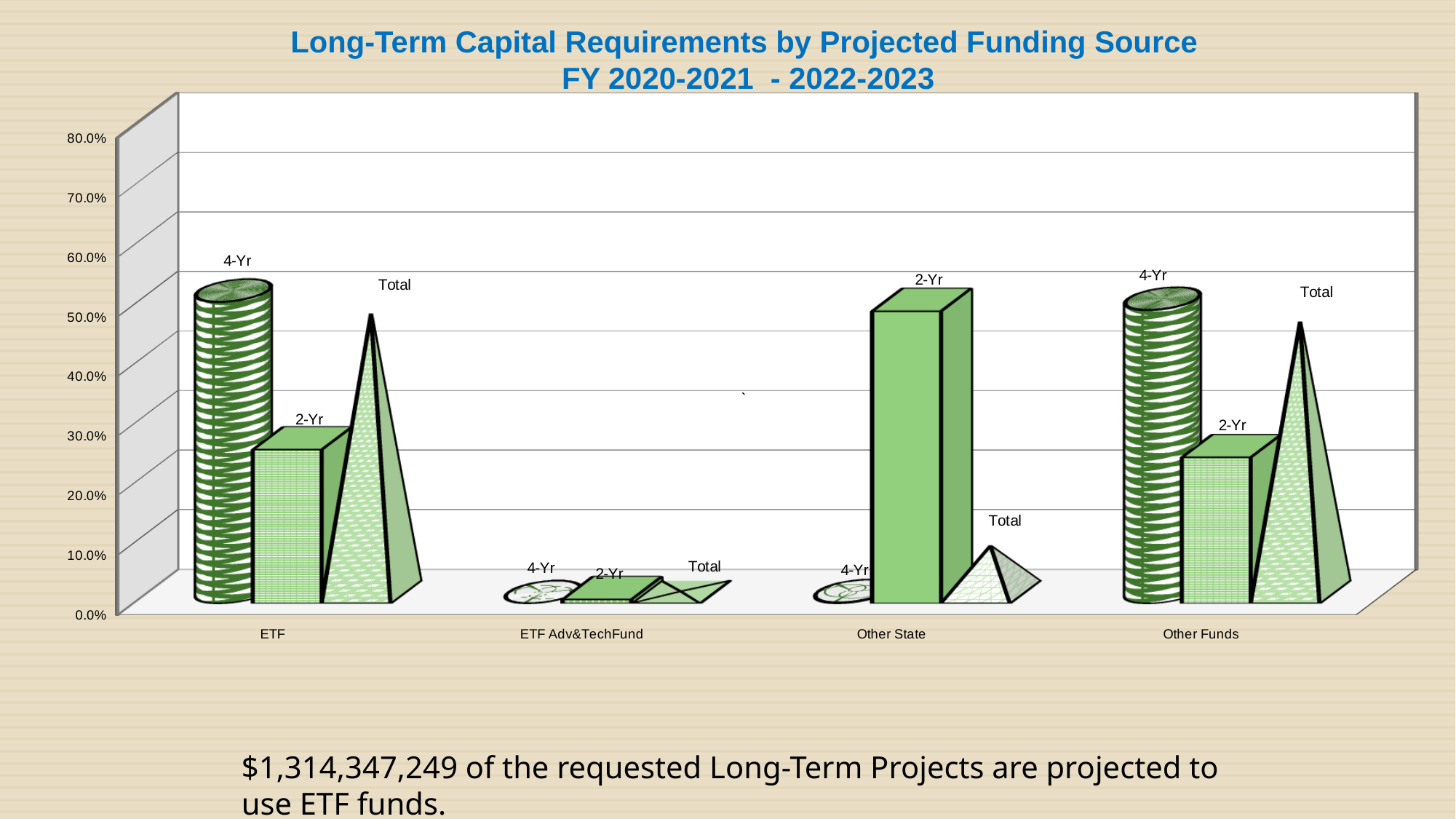
Is the 4-Yr value for ETF Adv&TechFund greater or less than 10.0%? less What is the title of the chart? Long-Term Capital Requirements by Projected Funding Source FY 2020-2021 - 2022-2023 Within the ETF category, which series has the highest value? 4-Yr Is the 4-Yr value for ETF greater or less than 40.0%? greater Is the 2-Yr value for ETF greater or less than 40.0%? less Which funding source has the lowest values across all three series? ETF Adv&TechFund Which is larger for Other State: the 4-Yr value or the 2-Yr value? 2-Yr Within the Other State category, which series has the highest value? 2-Yr How many series (4-Yr, 2-Yr, Total) are plotted for each funding source? 3 What kind of chart is shown on the slide? bar chart How many funding source categories are shown on the x axis? 4